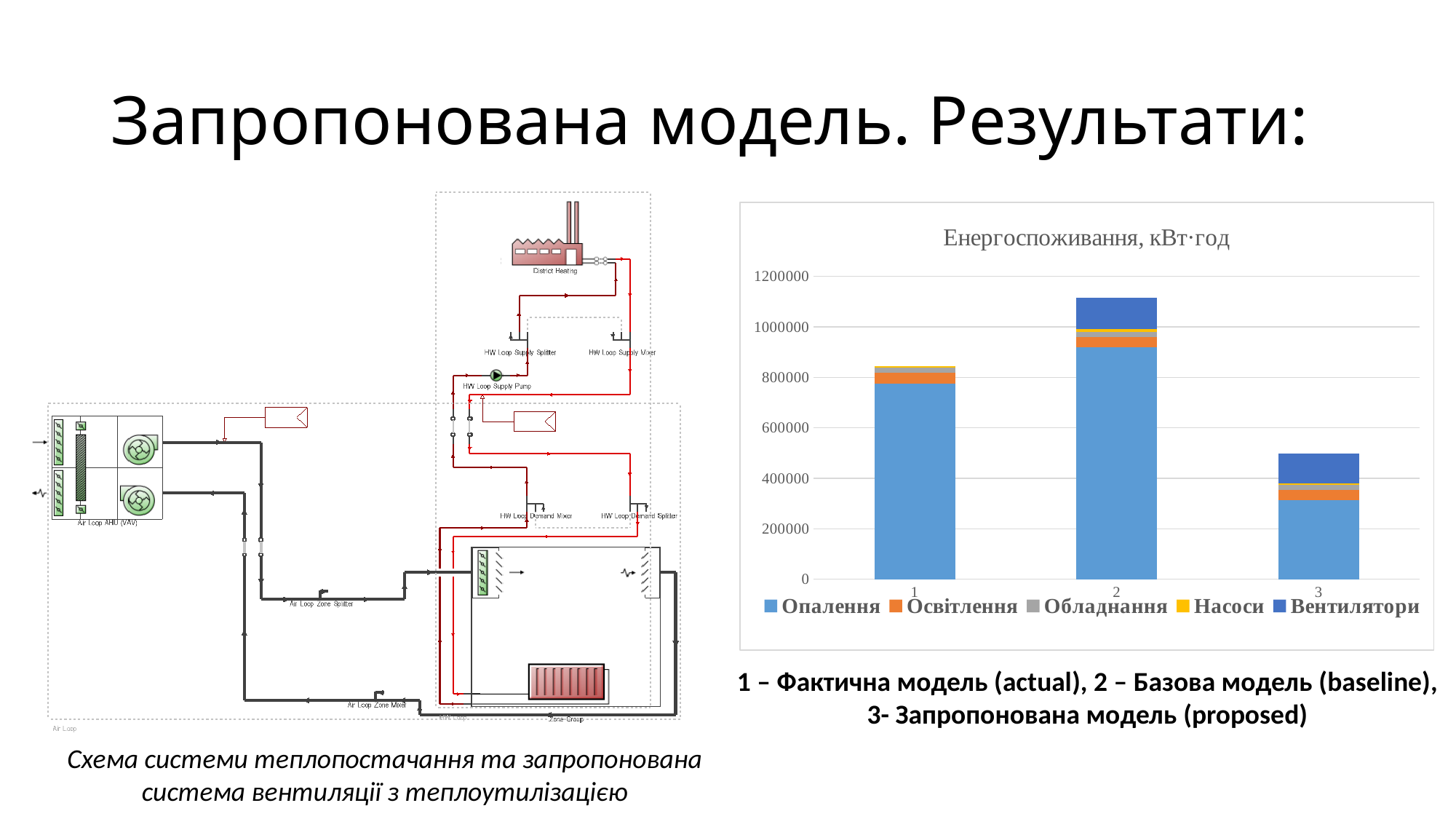
What is the title of the chart? Енергоспоживання, кВт·год Is the Опалення value for category 3 greater or less than 400000? less Which has the larger total energy consumption, category 1 or category 3? 1 How many series does the chart legend list? 5 What kind of chart is shown on the slide? stacked bar chart Which series is listed first in the chart legend? Опалення Which category has the lowest total energy consumption? 3 How many categories are shown on the x axis of the chart? 3 Is the total value for category 1 greater or less than 800000? greater Is the total value for category 3 greater or less than 600000? less Which category has the highest total energy consumption? 2